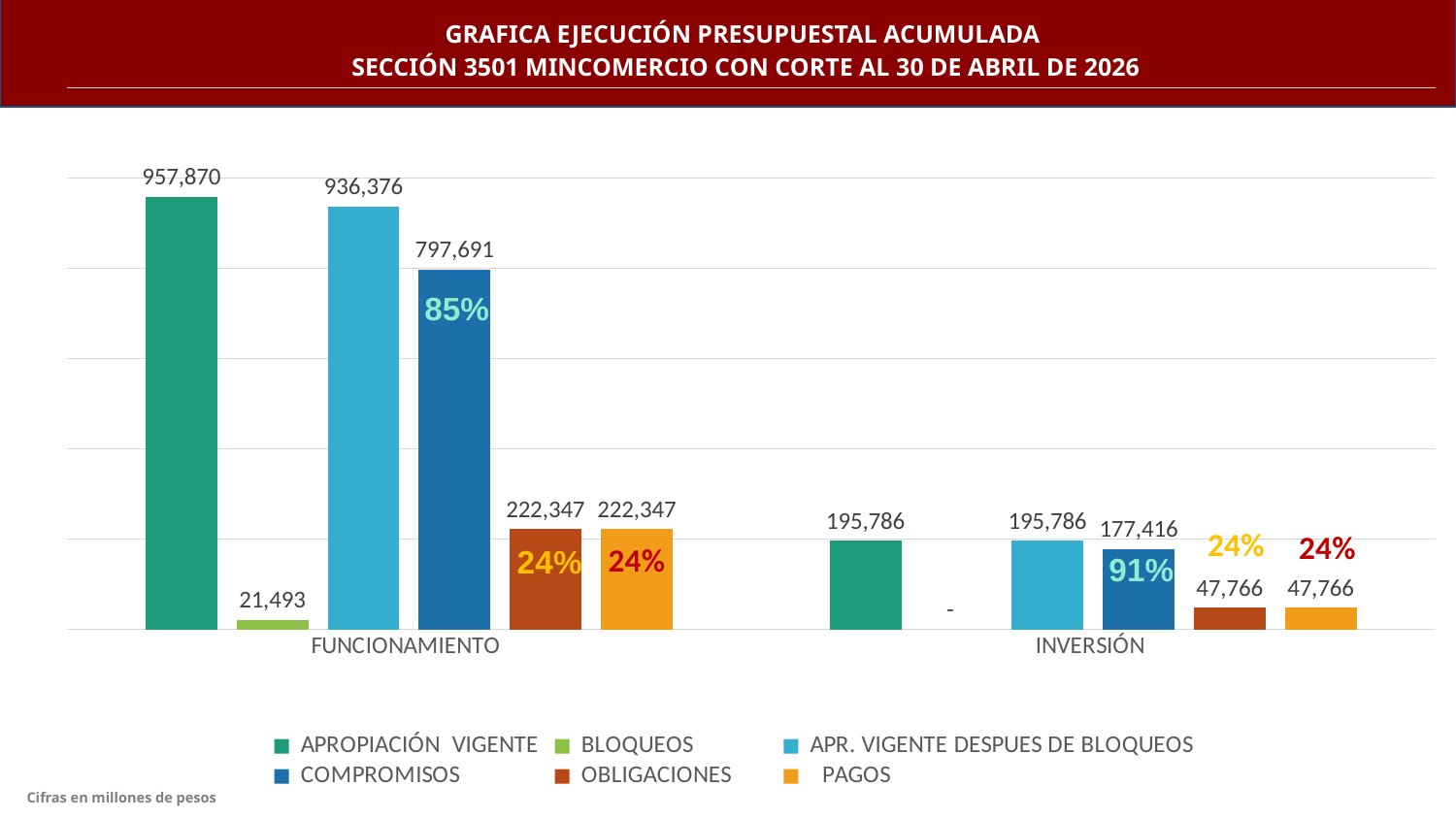
What percentage label is shown on the COMPROMISOS bar for INVERSIÓN? 91% What is the value of APROPIACIÓN VIGENTE for FUNCIONAMIENTO? 957,870 How many categories are shown on the x axis? 2 What is the difference between APROPIACIÓN VIGENTE and APR. VIGENTE DESPUES DE BLOQUEOS for FUNCIONAMIENTO? 21,494 What is the difference between APROPIACIÓN VIGENTE and COMPROMISOS for INVERSIÓN? 18,370 What is the value of BLOQUEOS for FUNCIONAMIENTO? 21,493 What is the value of PAGOS for INVERSIÓN? 47,766 What is the value of COMPROMISOS for INVERSIÓN? 177,416 How many series does the legend list? 6 Which is larger, COMPROMISOS for FUNCIONAMIENTO or COMPROMISOS for INVERSIÓN? COMPROMISOS for FUNCIONAMIENTO What is the value of OBLIGACIONES for FUNCIONAMIENTO? 222,347 Which series has the lowest value for FUNCIONAMIENTO? BLOQUEOS